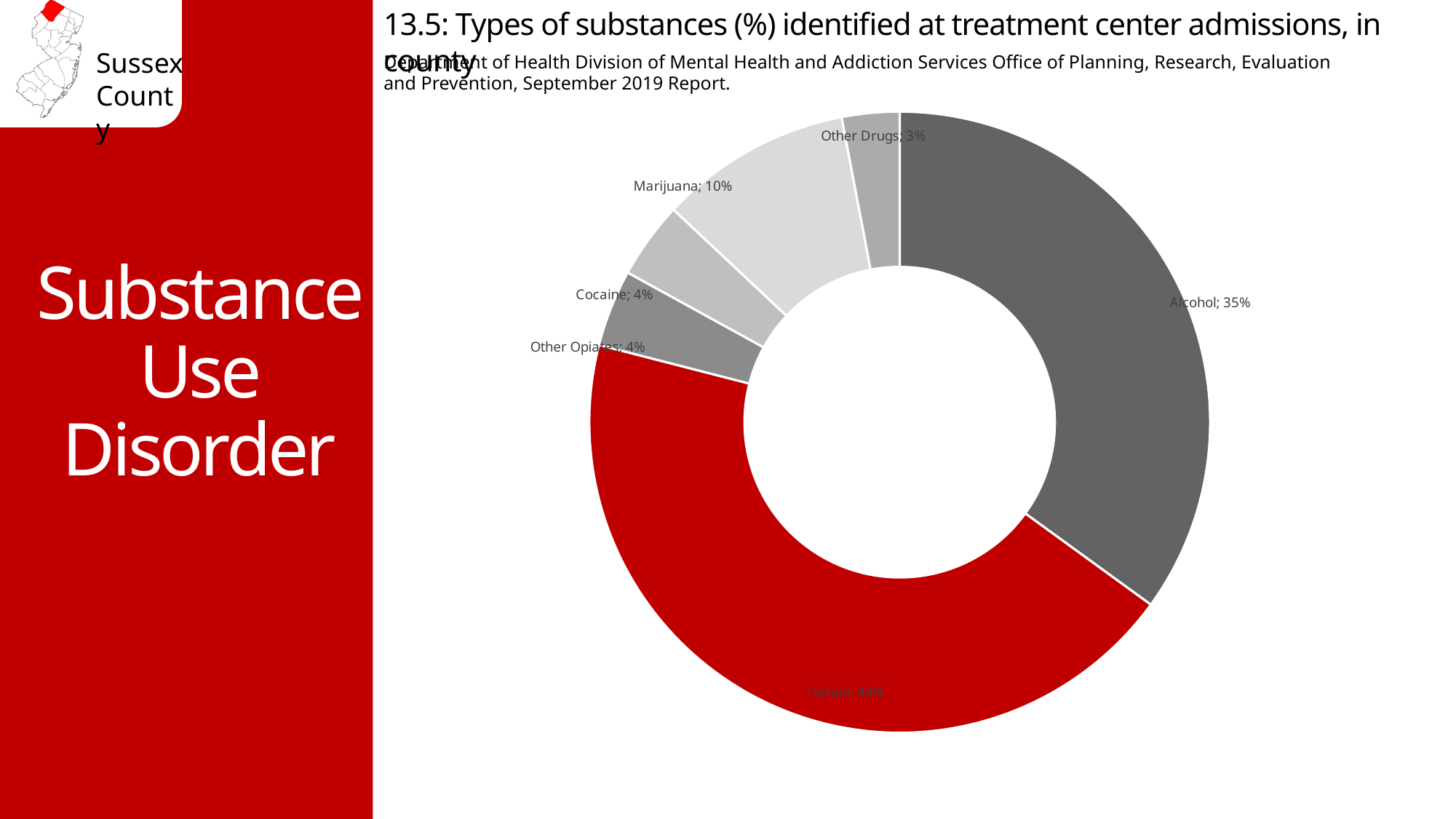
Which substance has the smallest share of treatment center admissions? Other Drugs Which has a larger share, Marijuana or Cocaine? Marijuana Which substance has the largest share of treatment center admissions? Heroin What is the difference in percentage points between Heroin and Alcohol? 9 How many substance categories are shown in the chart? 6 What kind of chart is shown on the slide? Doughnut chart What percentage of treatment center admissions identified Marijuana? 10% What percentage of treatment center admissions identified Other Drugs? 3% What percentage of treatment center admissions identified Alcohol? 35% What percentage of treatment center admissions identified Heroin? 44% Which substance's slice is coloured red in the chart? Heroin What percentage of treatment center admissions identified Cocaine? 4%